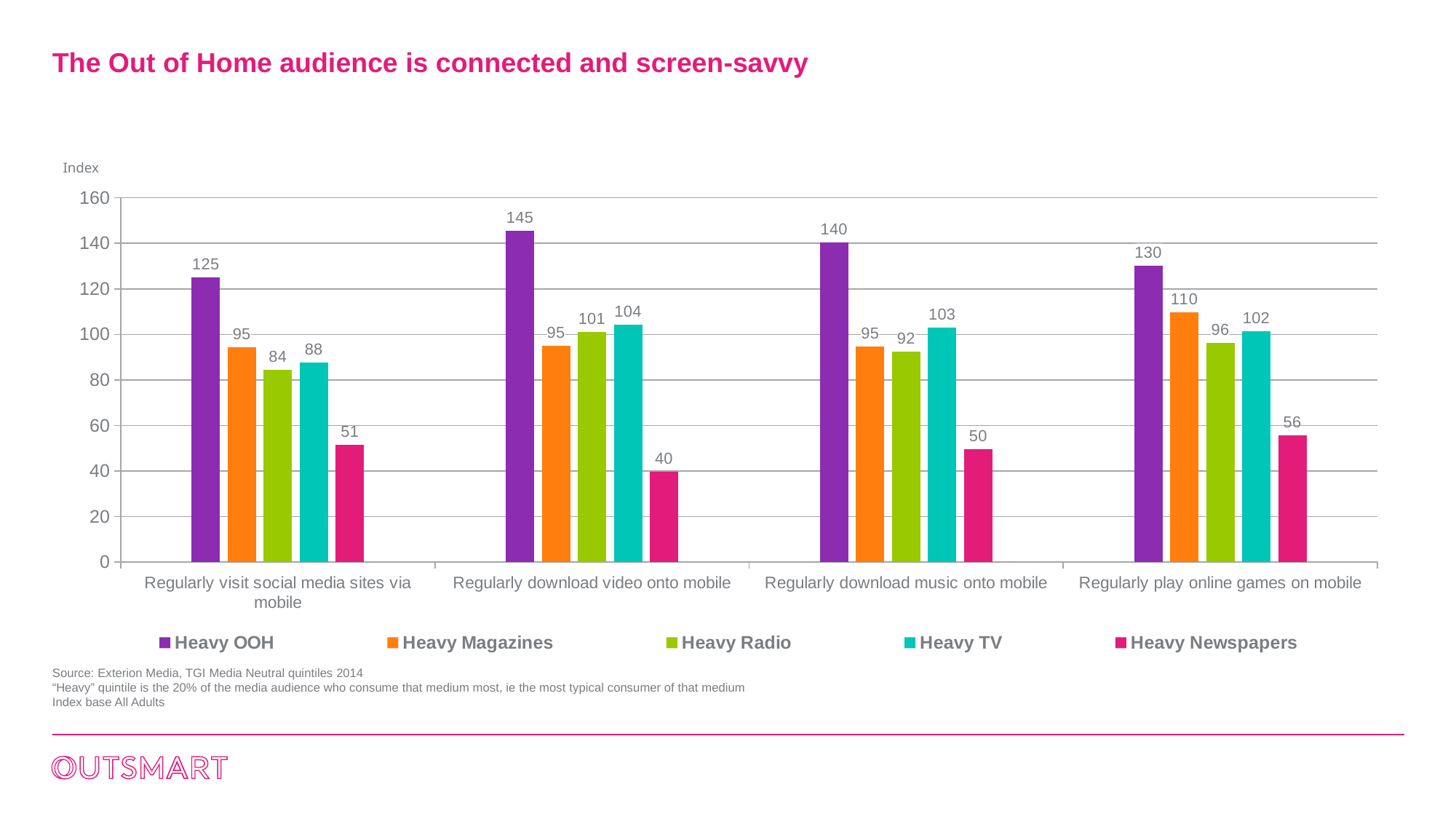
What kind of chart is shown on the slide? Bar chart What is the difference between the Heavy OOH and Heavy Magazines index for 'Regularly play online games on mobile'? 20 Which series has the highest index for 'Regularly play online games on mobile'? Heavy OOH Which colour represents Heavy Magazines in the legend? Orange What is the Heavy TV index for 'Regularly download music onto mobile'? 103 How many categories are shown on the x axis? 4 How many series does the legend list? 5 Which is larger for 'Regularly visit social media sites via mobile': the Heavy Radio index or the Heavy TV index? Heavy TV Which series has the lowest index for 'Regularly download video onto mobile'? Heavy Newspapers What is the Heavy Newspapers index for 'Regularly visit social media sites via mobile'? 51 What is the Heavy OOH index for 'Regularly download video onto mobile'? 145 What is the title of the slide? The Out of Home audience is connected and screen-savvy